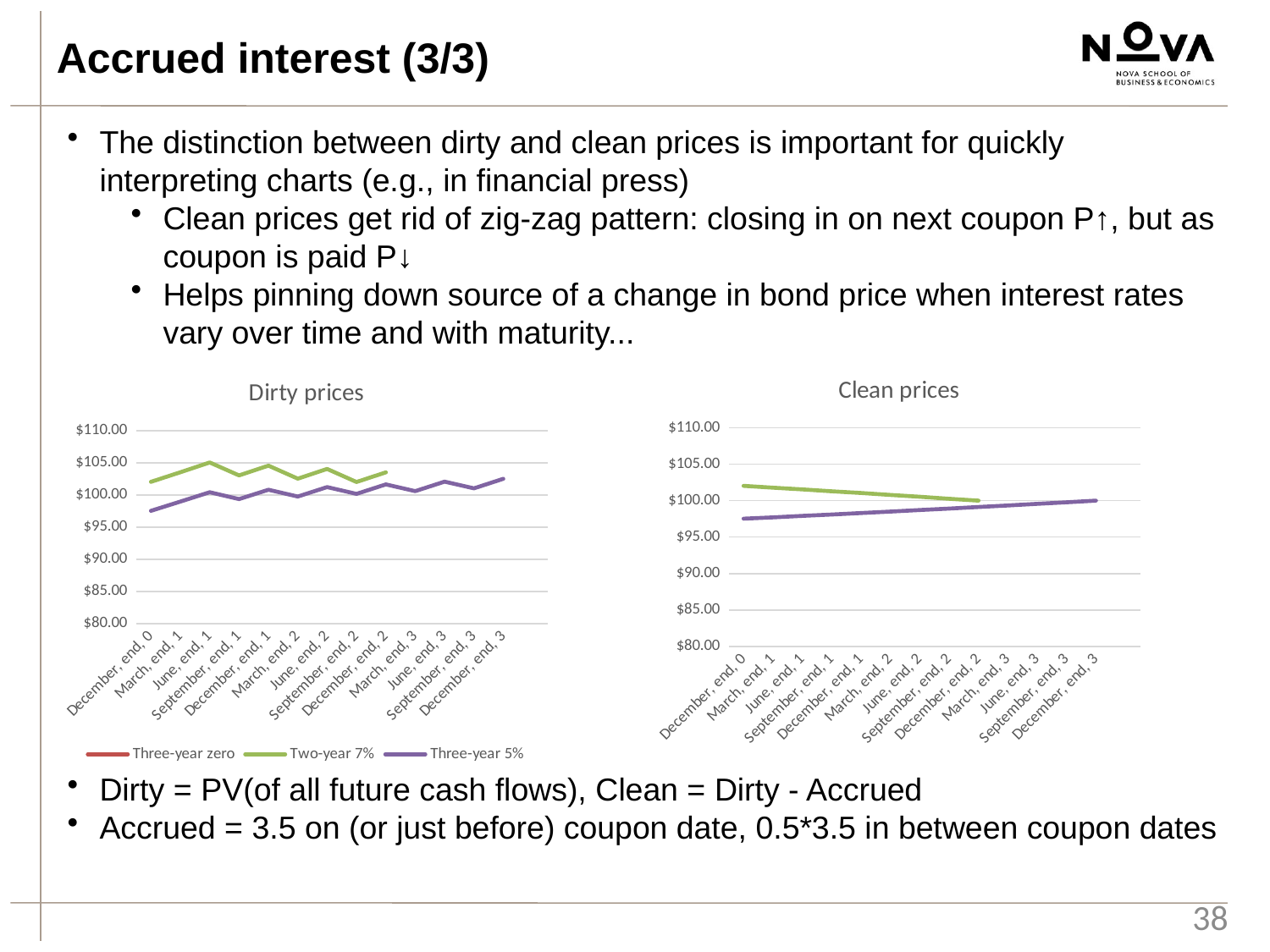
What kind of chart is the "Clean prices" chart? Line chart In the "Dirty prices" chart, at "December, end, 0", which series has the higher value: Two-year 7% or Three-year 5%? Two-year 7% In the "Clean prices" chart, does the green line rise or fall from "December, end, 0" to "December, end, 2"? Fall In the "Dirty prices" chart, how many series does the legend list? 3 In the "Dirty prices" chart, how many categories are shown on the x axis? 13 In the "Dirty prices" chart, is the value for Three-year 5% at "December, end, 3" greater or less than $100.00? greater In the "Dirty prices" chart, is the value for Two-year 7% at "December, end, 0" greater or less than $100.00? greater In the "Clean prices" chart, does the purple line rise or fall from "December, end, 0" to "December, end, 3"? Rise What kind of chart is the "Dirty prices" chart? Line chart In the "Clean prices" chart, is the value of the green line at "December, end, 0" greater or less than $100.00? greater What are the legend entries of the "Dirty prices" chart? Three-year zero, Two-year 7%, Three-year 5%